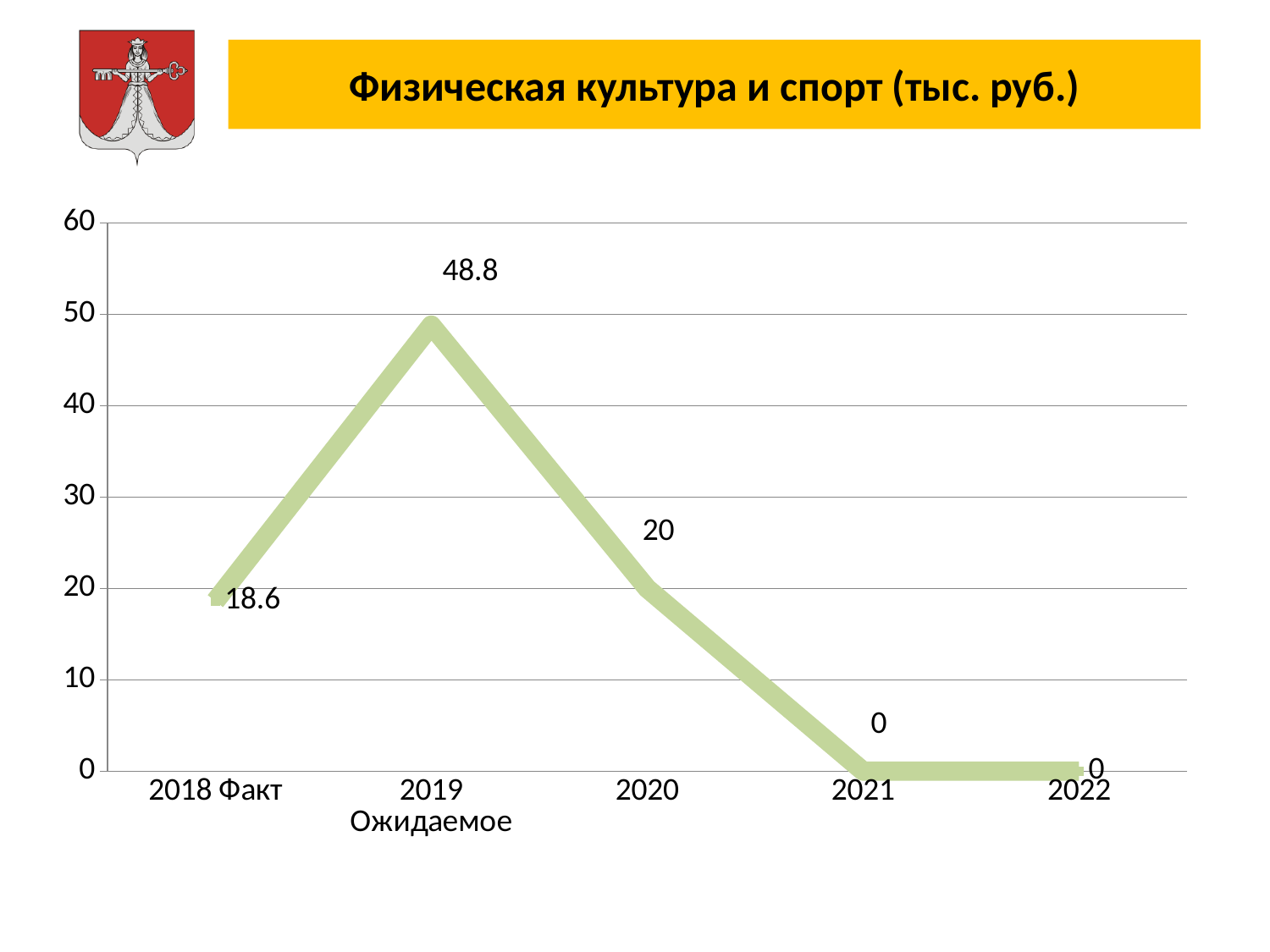
Do the values rise or fall from 2019 Ожидаемое to 2021? fall Is the value for 2019 Ожидаемое greater or less than 40? greater What is the difference between the values for 2019 Ожидаемое and 2020? 28.8 What kind of chart is shown on the slide? line chart What is the value for 2019 Ожидаемое? 48.8 Which is larger, the value for 2018 Факт or the value for 2020? 2020 What is the difference between the values for 2019 Ожидаемое and 2018 Факт? 30.2 What is the value for 2018 Факт? 18.6 Which category has the highest value? 2019 Ожидаемое How many categories are shown on the x axis? 5 What is the value for 2021? 0 What is the value for 2020? 20